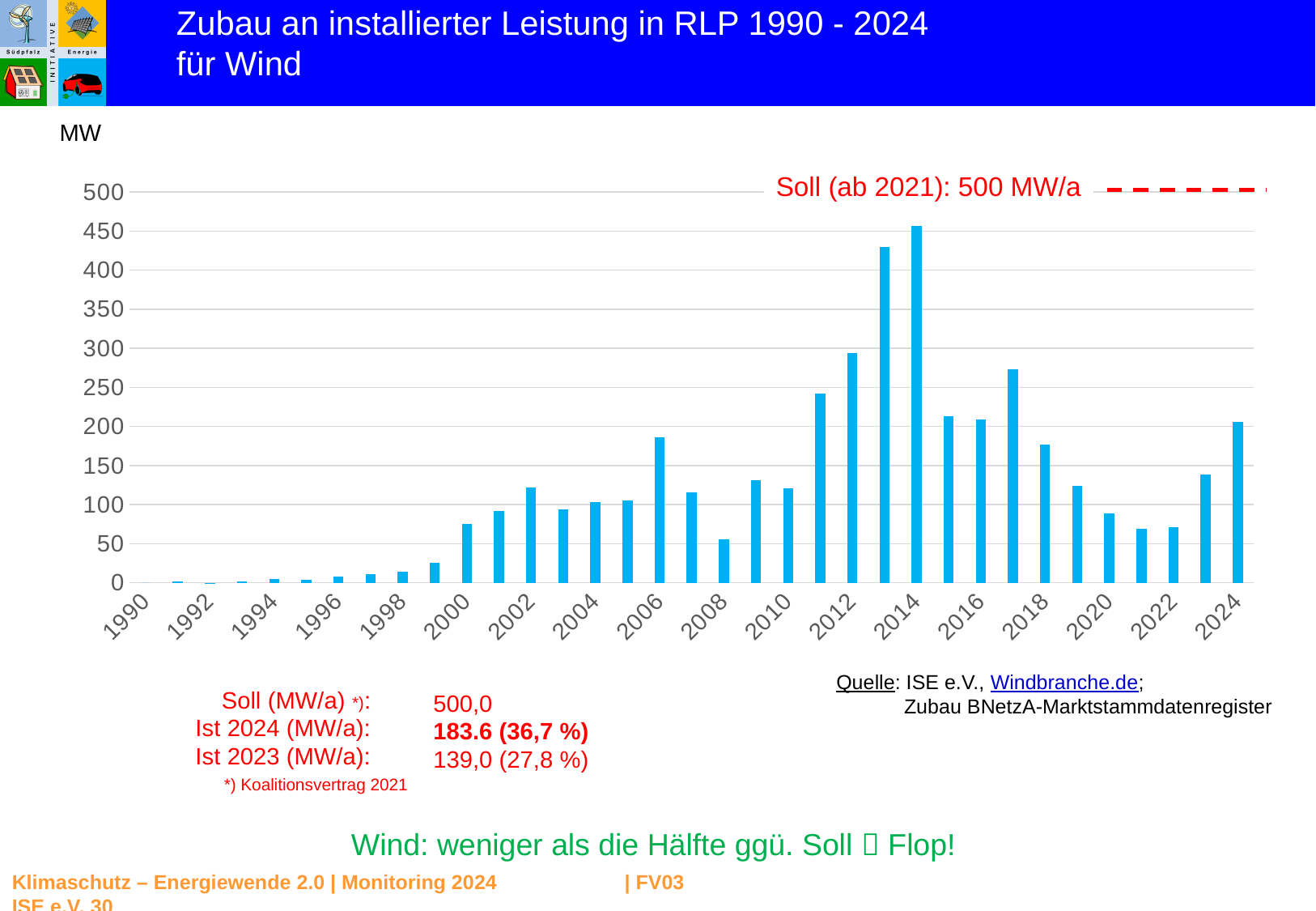
Which year has the larger value, 2017 or 2018? 2017 What is the Ist 2024 value in MW/a stated on the slide? 183.6 Which year has the larger value, 2024 or 2023? 2024 How many years (bars) are plotted in the chart? 35 Is the value for 2020 greater or less than 100? less Is the value for 2017 greater or less than 250? greater Is the value for 2013 greater or less than 400? greater What is the Soll target per year shown by the dashed red line? 500 MW/a What unit is shown on the y axis of the chart? MW What kind of chart is shown on the slide? bar chart Which year has the highest wind capacity addition in the chart? 2014 What is the Ist 2023 value in MW/a stated on the slide? 139,0